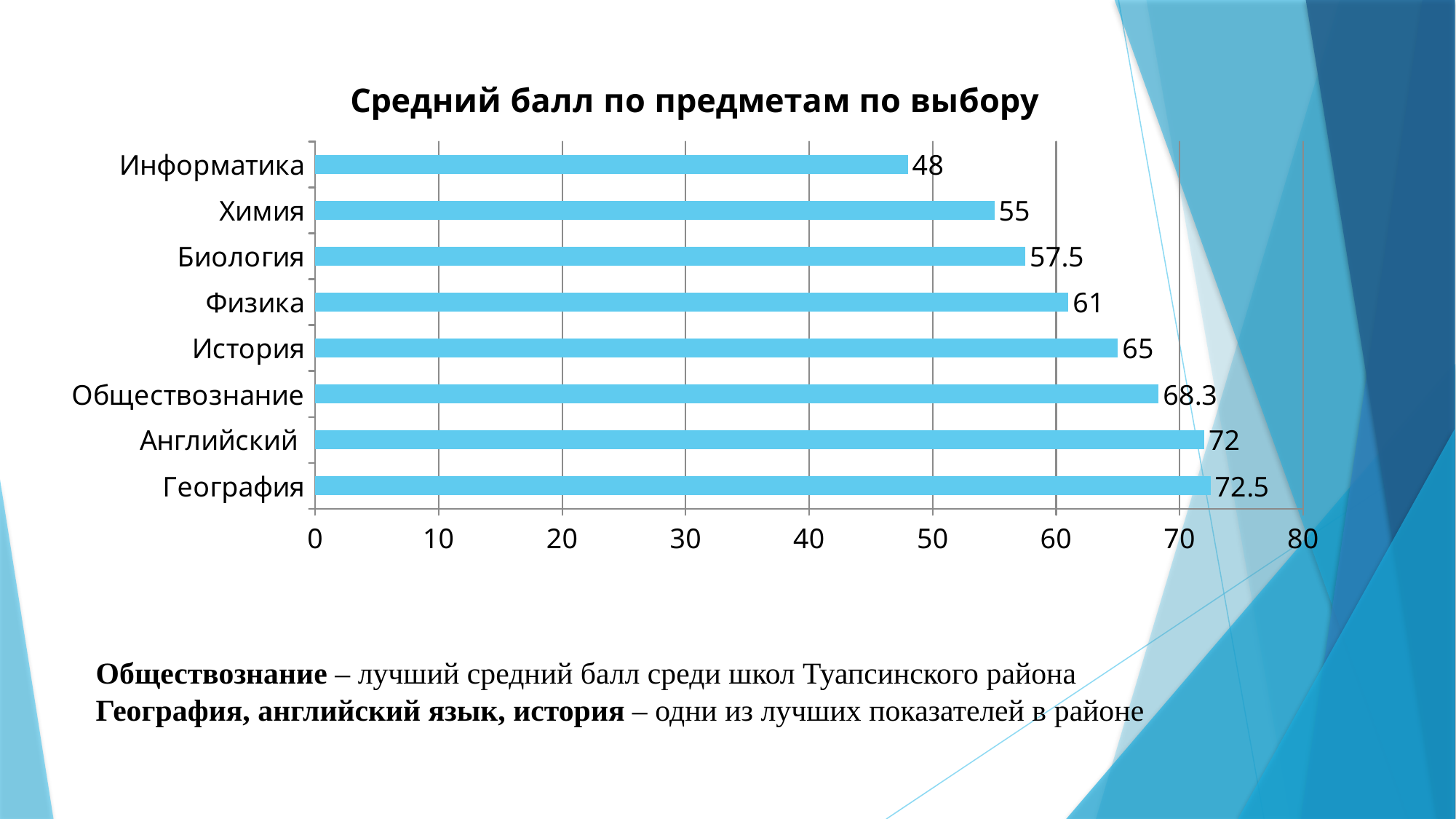
What is the difference between the average scores for География and Информатика? 24.5 Is the value for Английский greater or less than 70? greater What is the average score for Информатика? 48 How many subjects are shown in the chart? 8 What is the average score for Обществознание? 68.3 What is the title of the chart? Средний балл по предметам по выбору What is the difference between the average scores for История and Физика? 4 Which subject has the highest average score? География Which subject has the lowest average score? Информатика Which has a higher average score, Химия or Физика? Физика What is the average score for Биология? 57.5 What kind of chart is shown on the slide? Bar chart